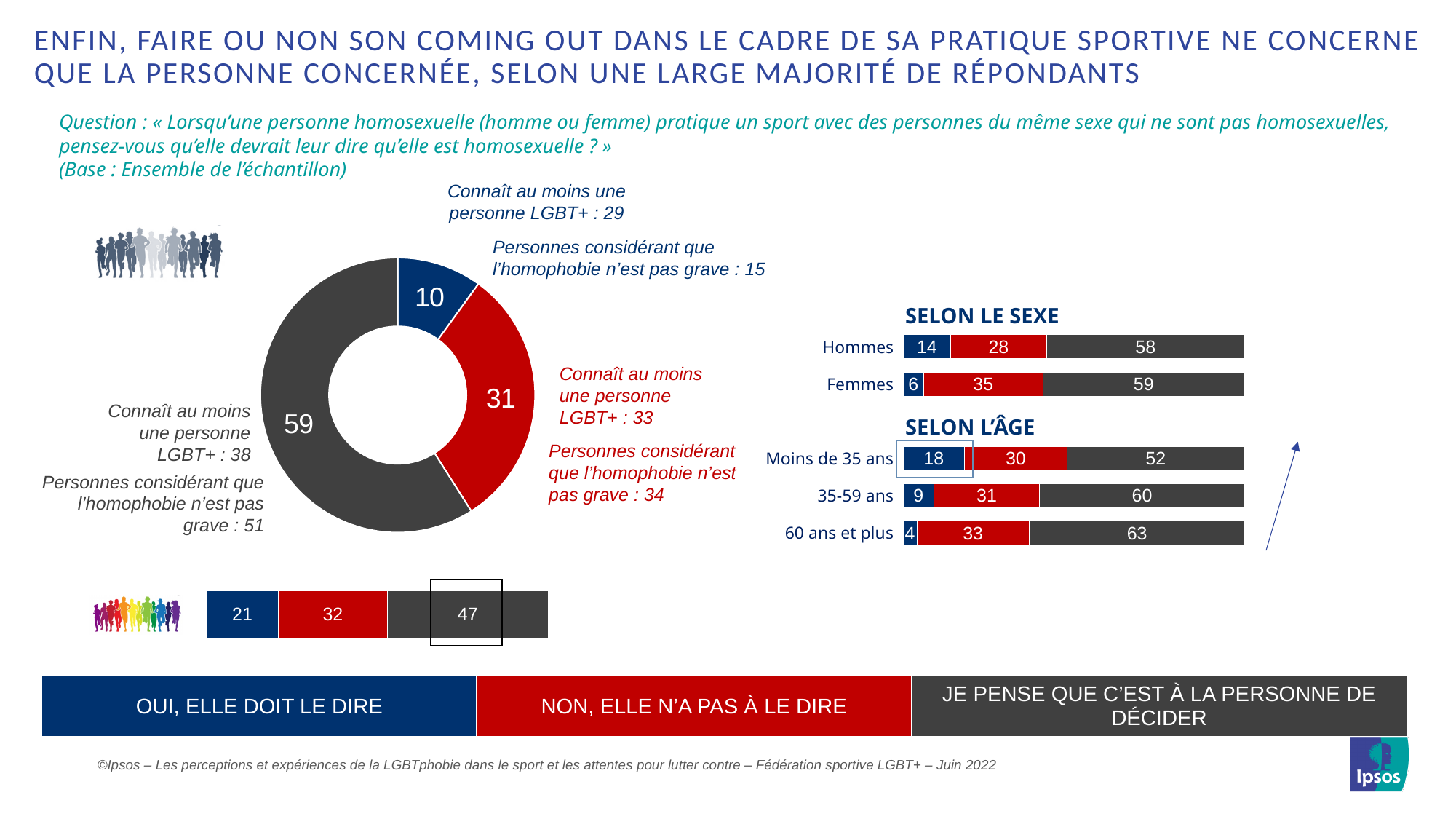
In the bottom stacked bar (LGBT+ respondents), what is the value for "Non, elle n'a pas à le dire"? 32 In the bottom stacked bar (LGBT+ respondents), is the value for "Oui, elle doit le dire" larger or smaller than the value for "Je pense que c'est à la personne de décider"? smaller In the "Selon l'âge" bar chart, which age group has the highest value for "Oui, elle doit le dire"? Moins de 35 ans In the donut chart, what is the value for "Je pense que c'est à la personne de décider"? 59 In the donut chart, which response has the largest share? Je pense que c'est à la personne de décider In the "Selon l'âge" bar chart, how many age groups are shown? 3 In the "Selon le sexe" bar chart, what is the difference between Hommes and Femmes for "Oui, elle doit le dire"? 8 In the "Selon le sexe" bar chart, what is the value for "Non, elle n'a pas à le dire" among Femmes? 35 What type of chart is used for the "Selon le sexe" breakdown? Stacked bar chart In the "Selon l'âge" bar chart, what is the value for "Je pense que c'est à la personne de décider" among 60 ans et plus? 63 In the donut chart, what share of respondents answered "Oui, elle doit le dire"? 10 In the "Selon l'âge" bar chart, which age group has the lowest value for "Je pense que c'est à la personne de décider"? Moins de 35 ans